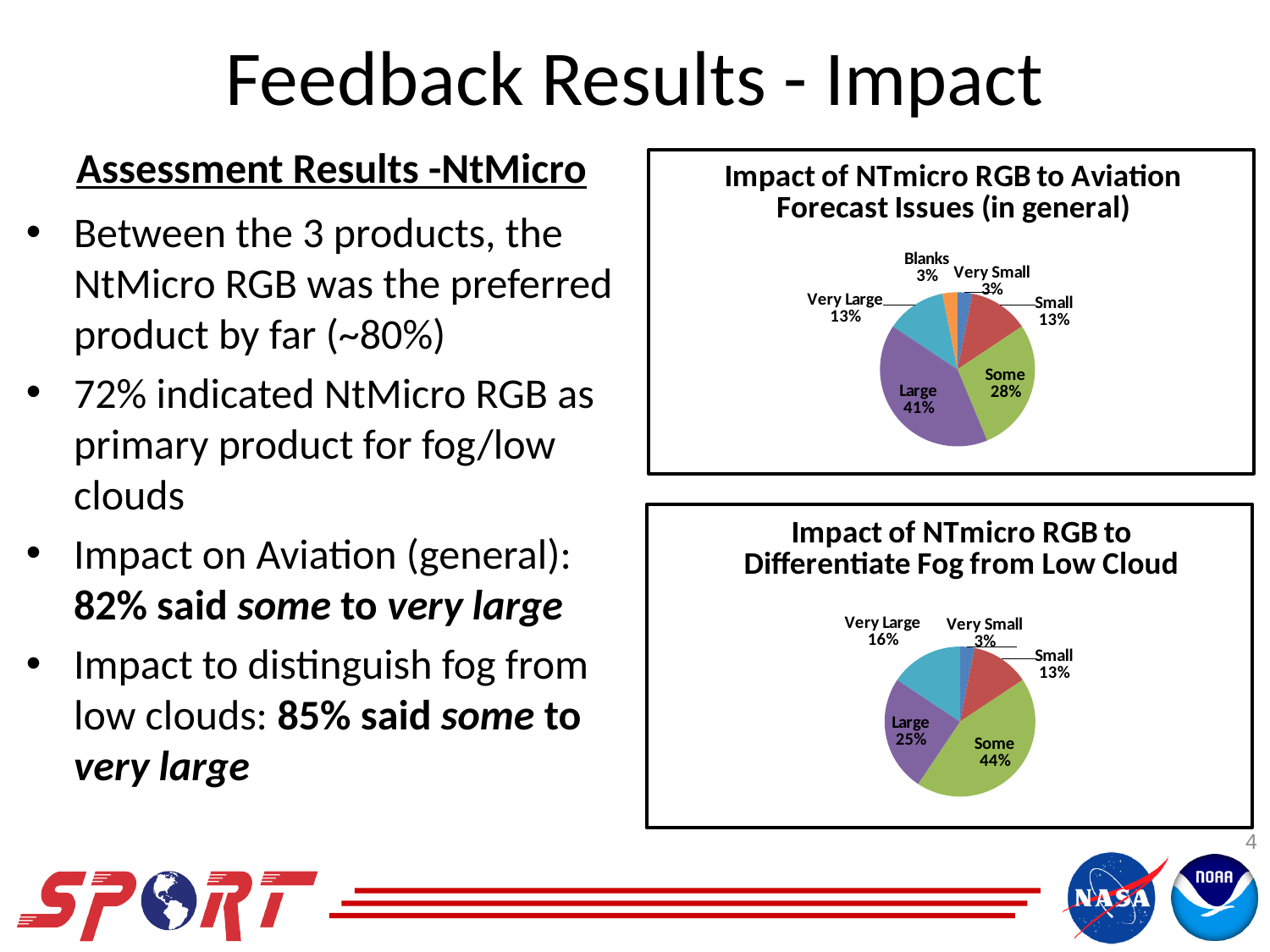
In the chart titled "Impact of NTmicro RGB to Aviation Forecast Issues (in general)", what share of the pie is labelled "Large"? 41% In the chart titled "Impact of NTmicro RGB to Aviation Forecast Issues (in general)", what percentage is shown for "Some"? 28% In the chart titled "Impact of NTmicro RGB to Differentiate Fog from Low Cloud", which category has the smallest slice? Very Small In the chart titled "Impact of NTmicro RGB to Differentiate Fog from Low Cloud", what share of the pie is labelled "Some"? 44% In the chart titled "Impact of NTmicro RGB to Differentiate Fog from Low Cloud", which is larger, "Large" or "Very Large"? Large In the chart titled "Impact of NTmicro RGB to Aviation Forecast Issues (in general)", what is the difference between the "Large" and "Some" percentages? 13% What type of chart is the bottom chart on the slide? Pie chart In the chart titled "Impact of NTmicro RGB to Aviation Forecast Issues (in general)", what percentage is shown for "Blanks"? 3% In the chart titled "Impact of NTmicro RGB to Aviation Forecast Issues (in general)", how many slices does the pie have? 6 In the chart titled "Impact of NTmicro RGB to Differentiate Fog from Low Cloud", what is the difference between the "Some" and "Large" percentages? 19% In the chart titled "Impact of NTmicro RGB to Aviation Forecast Issues (in general)", which category has the largest slice? Large In the chart titled "Impact of NTmicro RGB to Differentiate Fog from Low Cloud", how many slices does the pie have? 5